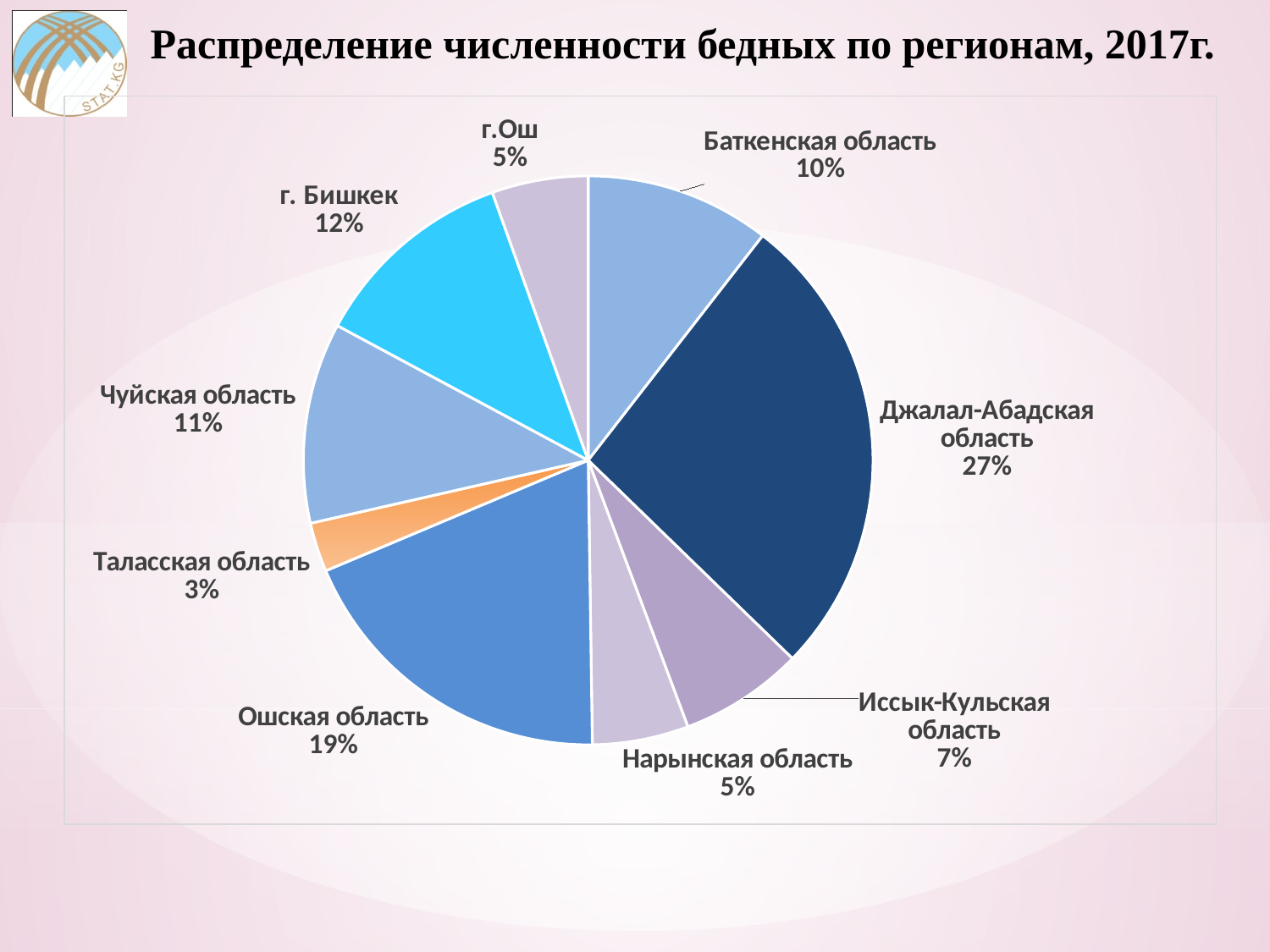
What is the title of the chart? Распределение численности бедных по регионам, 2017г. Which is larger, the share for Чуйская область or the share for Баткенская область? Чуйская область What share is shown for Таласская область? 3% Which region has the largest slice of the pie? Джалал-Абадская область What is the combined share of г.Ош and Нарынская область? 10% What share is shown for Ошская область? 19% What share is shown for г. Бишкек? 12% Which region has the smallest slice of the pie? Таласская область What is the difference between the shares of Джалал-Абадская область and Ошская область? 8% How many regions (slices) are shown in the pie chart? 9 What kind of chart is shown on the slide? pie chart